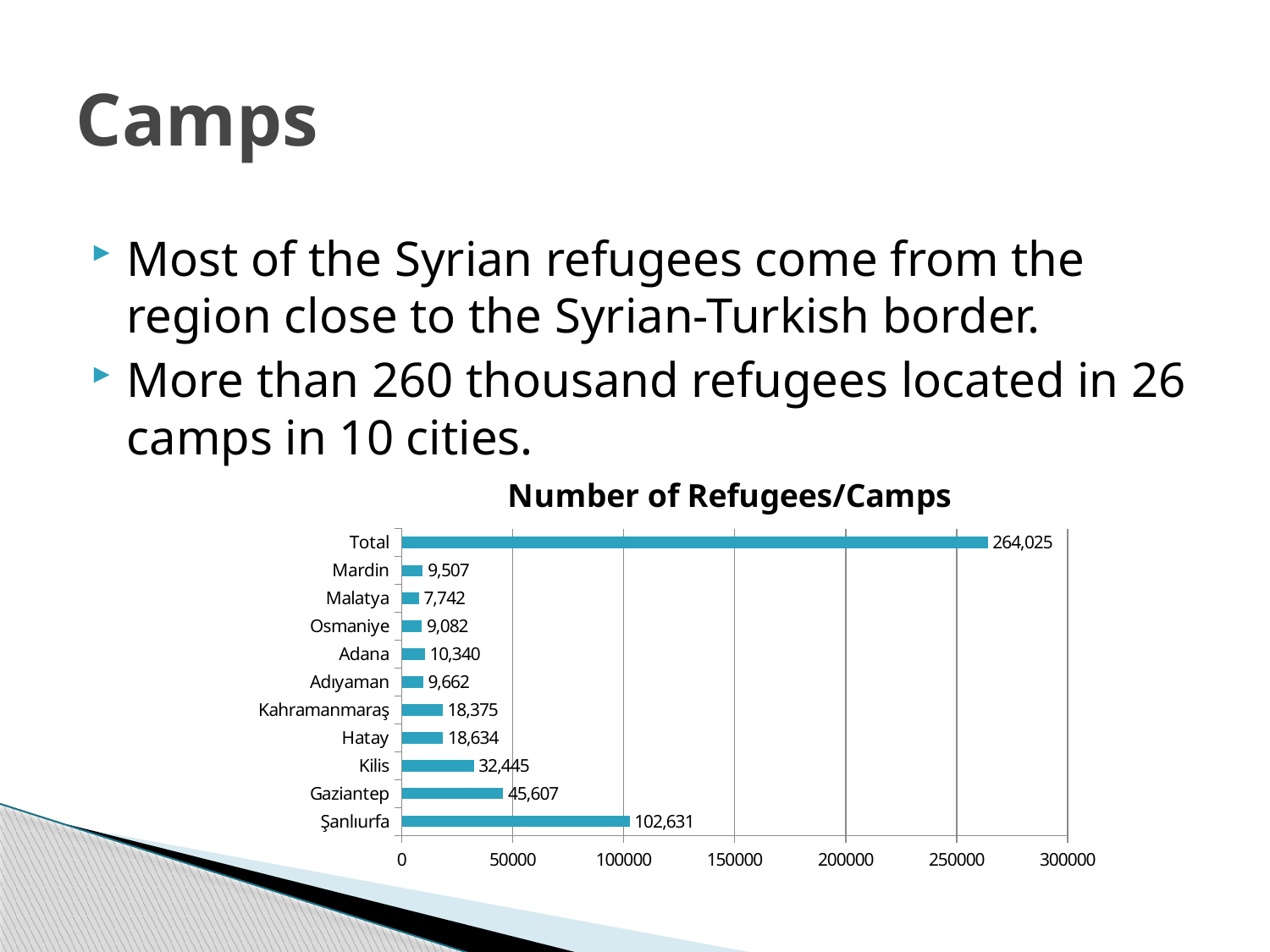
What is the value shown for Gaziantep? 45,607 Which city has the lowest number of refugees in camps? Malatya Excluding the Total bar, which city has the highest number of refugees in camps? Şanlıurfa What is the difference between the values for Gaziantep and Kilis? 13,162 What is the value for Şanlıurfa in the Number of Refugees/Camps chart? 102,631 What is the value shown for the Total bar? 264,025 What is the value shown for Kilis? 32,445 How many bars are shown in the chart, including the Total bar? 11 What type of chart is shown on the slide? Bar chart What is the difference between the values for Şanlıurfa and Gaziantep? 57,024 Is the value for Şanlıurfa greater or less than 100000? greater Which is larger, the value for Adana or the value for Mardin? Adana